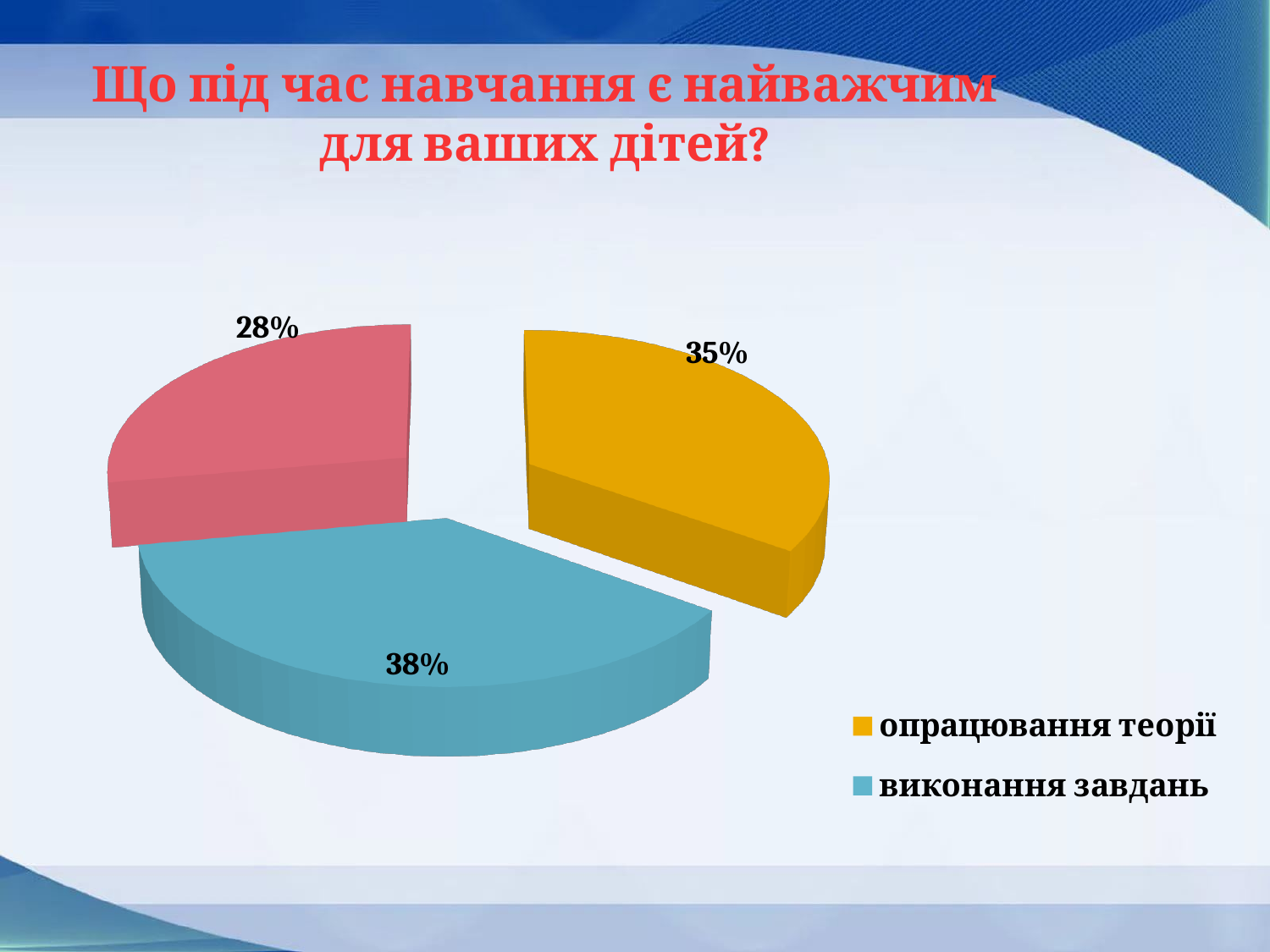
What percentage is shown for "опрацювання теорії"? 35% How many slices does the pie chart have? 3 What percentage is shown on the pink slice of the pie chart? 28% Which legend category has the largest share of the pie? виконання завдань What percentage is shown for "виконання завдань"? 38% What colour is the slice for "виконання завдань"? Blue What type of chart is shown on the slide? Pie chart What is the smallest percentage shown on the pie chart? 28% Which is larger: the share for "опрацювання теорії" or for "виконання завдань"? виконання завдань What is the title of the slide? Що під час навчання є найважчим для ваших дітей? How many entries does the legend list? 2 What is the difference in percentage points between "виконання завдань" and "опрацювання теорії"? 3 percentage points